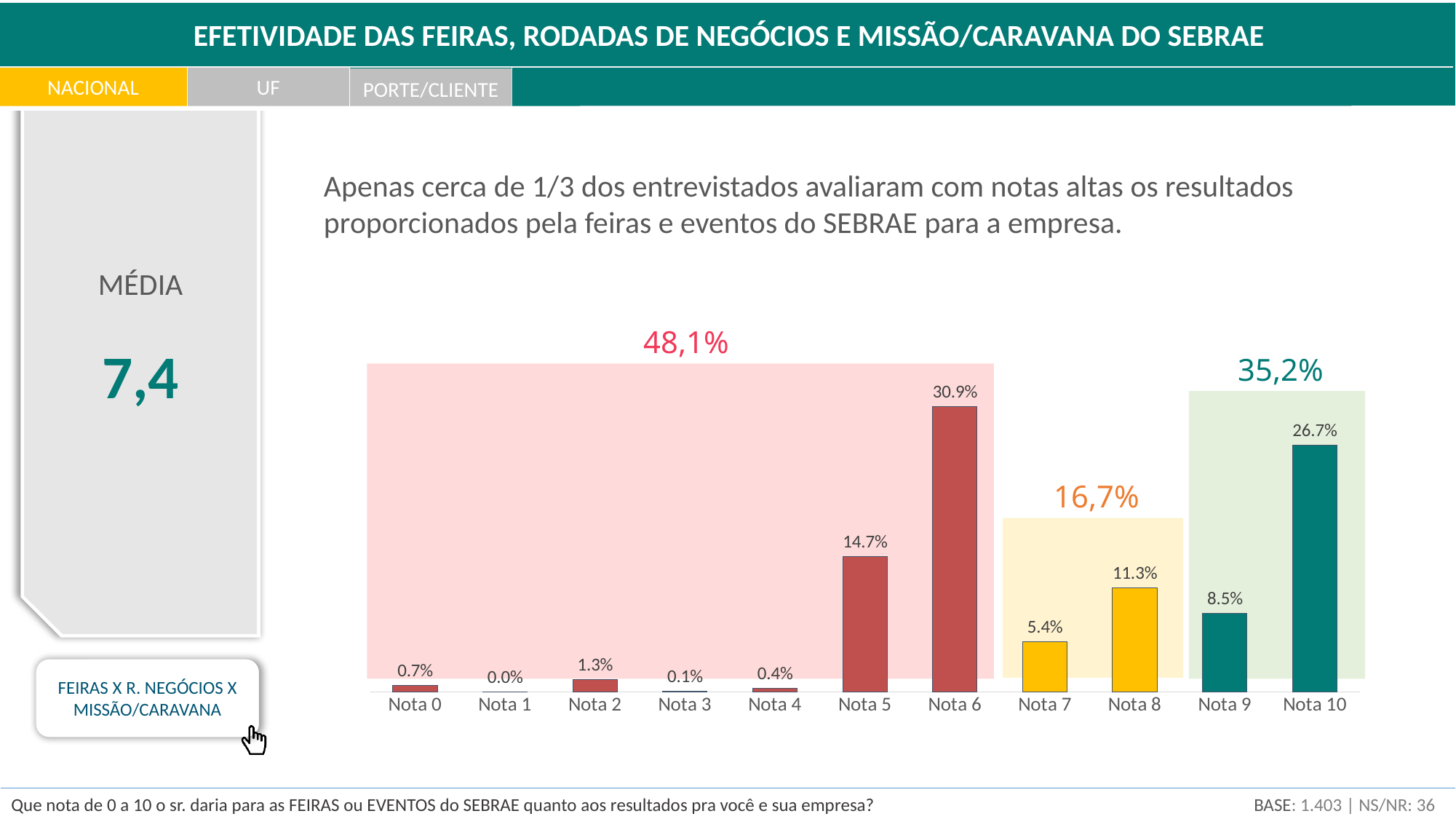
What is the combined share shown for the group Nota 9 and Nota 10? 35,2% What kind of chart is shown on the slide? Bar chart Which category has the lowest value? Nota 1 What is the value for Nota 8? 11.3% What is the difference between the values for Nota 6 and Nota 10? 4.2% Which is larger, the value for Nota 5 or the value for Nota 8? Nota 5 Which category has the highest value? Nota 6 What is the MÉDIA (average) value shown on the slide? 7,4 What is the value for Nota 6? 30.9% What is the value for Nota 10? 26.7% What is the combined share shown for the group Nota 0 to Nota 6? 48,1% How many categories are shown on the x axis? 11